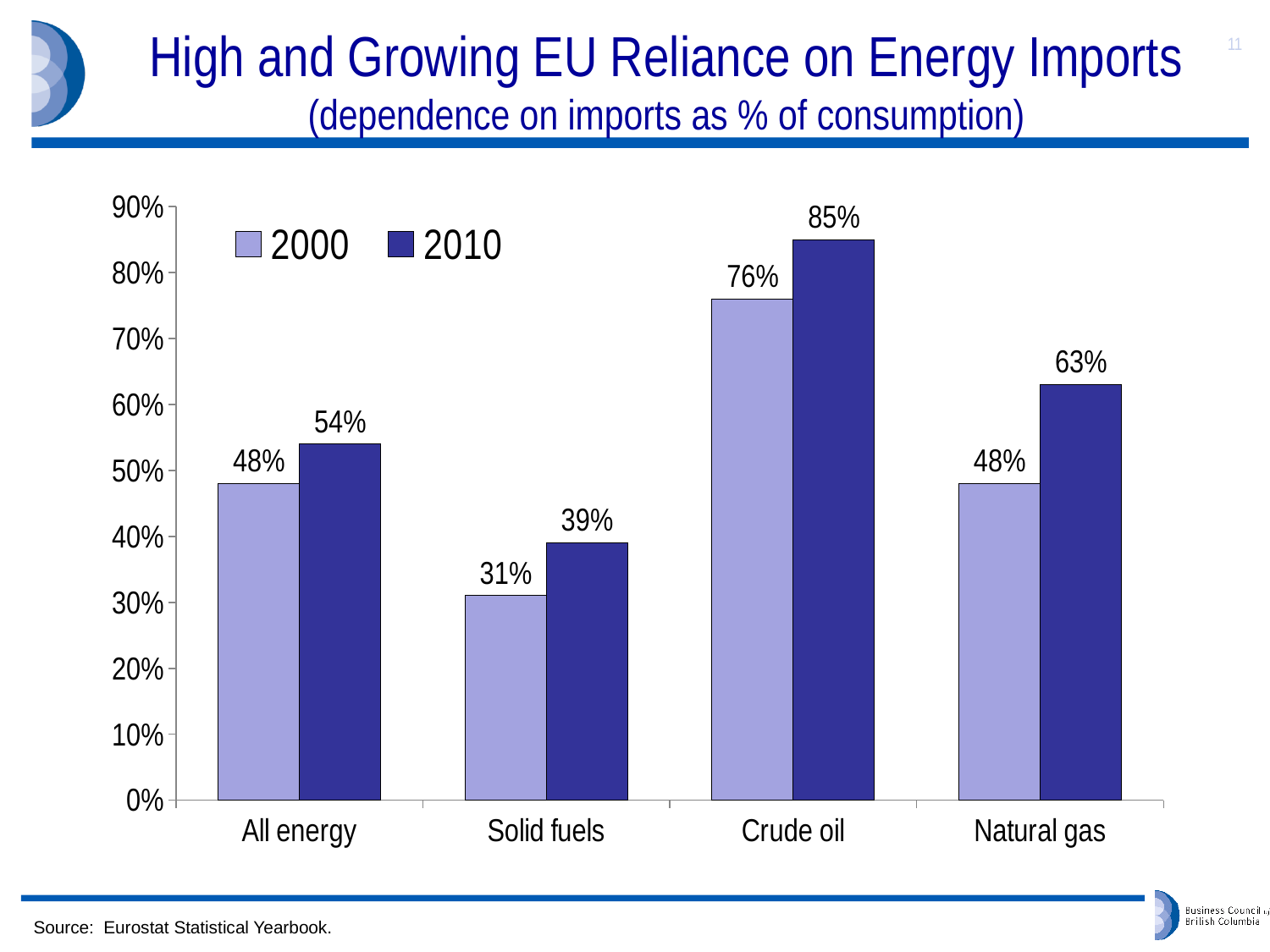
What is the difference between the 2010 and 2000 values for Natural gas? 15% What is the difference between the 2010 and 2000 values for All energy? 6% What is the 2010 value for Natural gas? 63% How many categories are shown on the x axis? 4 Which category has the highest 2010 value? Crude oil How many series does the legend list? 2 Which category has the lowest 2000 value? Solid fuels Which is larger, the 2000 value for Crude oil or the 2010 value for Natural gas? 2000 value for Crude oil What is the 2010 value for Crude oil? 85% What kind of chart is shown on the slide? Bar chart What is the 2000 value for Solid fuels? 31% Which series is shown in the darker blue colour? 2010